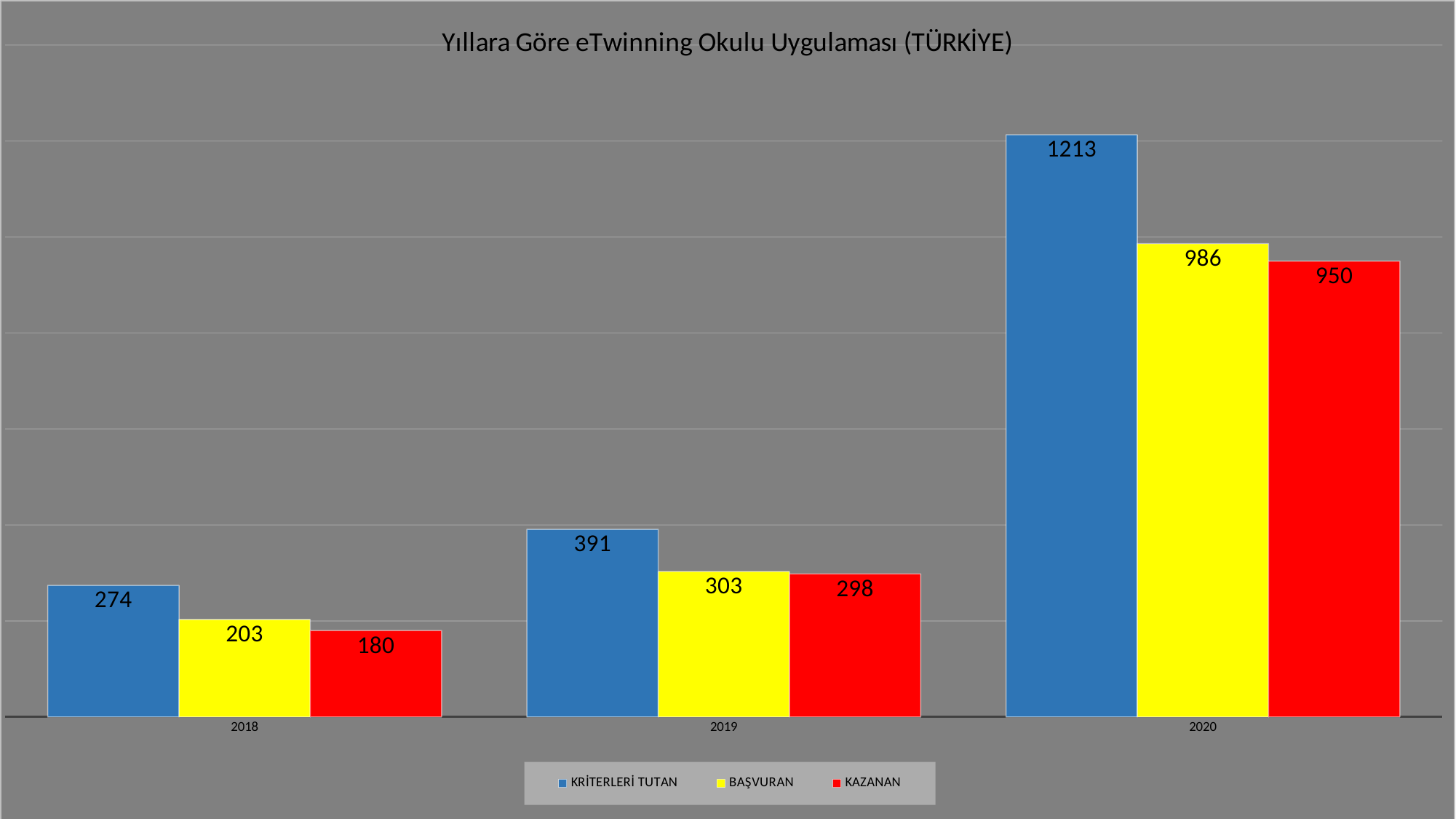
What is the difference between KRİTERLERİ TUTAN in 2019 and in 2018? 117 What is the value for BAŞVURAN in 2018? 203 Which is larger in 2019: KRİTERLERİ TUTAN or BAŞVURAN? KRİTERLERİ TUTAN How many series does the legend list? 3 Which year has the highest value for KAZANAN? 2020 What is the value for KRİTERLERİ TUTAN in 2020? 1213 What is the difference between BAŞVURAN and KAZANAN in 2020? 36 Which year has the lowest value for KRİTERLERİ TUTAN? 2018 How many years are shown on the x axis? 3 What kind of chart is shown on the slide? bar chart What is the value for KAZANAN in 2019? 298 Do the values for BAŞVURAN rise or fall from 2018 to 2020? rise